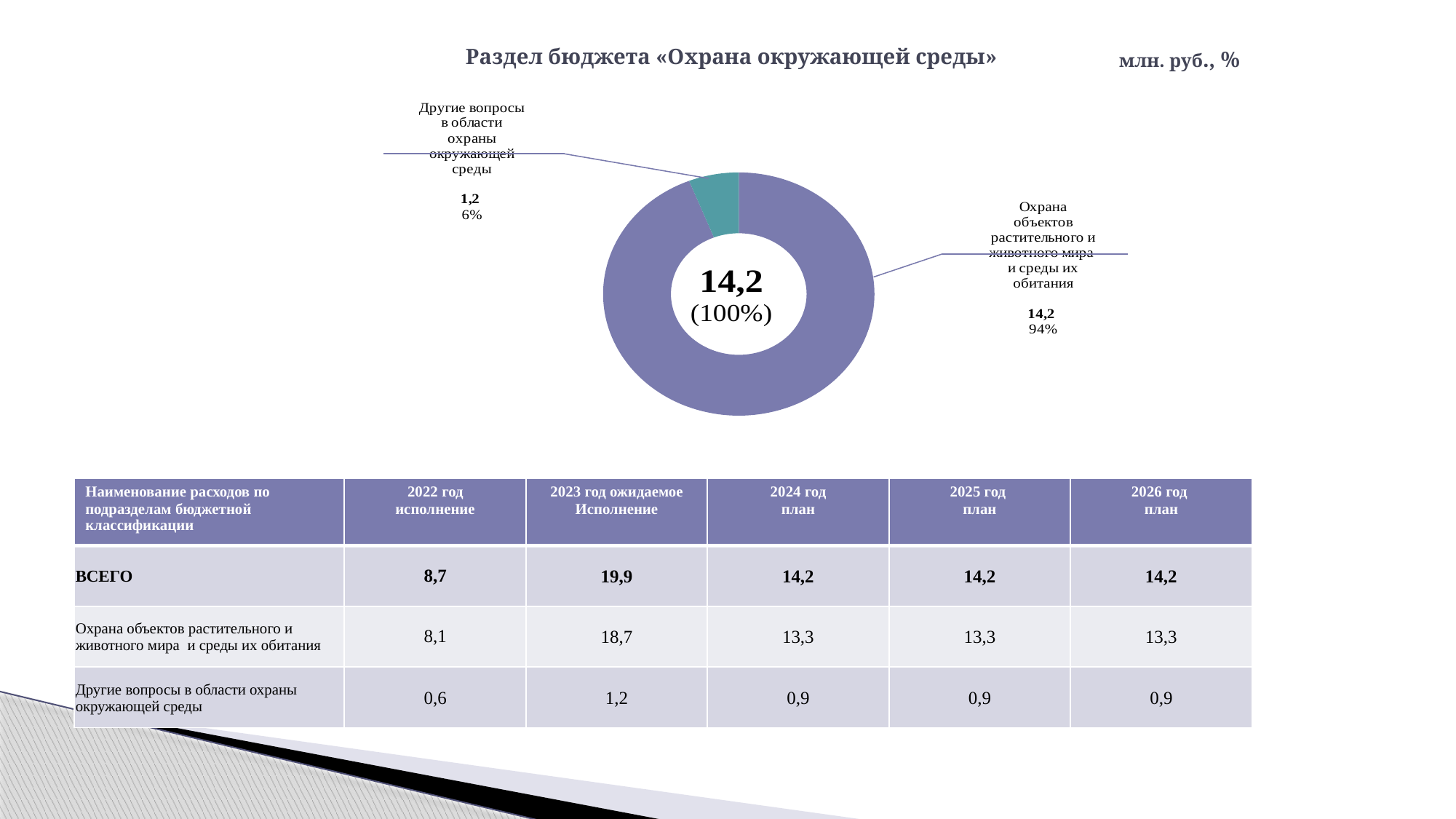
What percentage share is shown for «Другие вопросы в области охраны окружающей среды» in the donut chart? 6% Which is larger in the donut chart: the share for «Охрана объектов растительного и животного мира и среды их обитания» or the share for «Другие вопросы в области охраны окружающей среды»? Охрана объектов растительного и животного мира и среды их обитания Which slice of the donut chart is the largest? Охрана объектов растительного и животного мира и среды их обитания How many slices does the donut chart have? 2 Which slice of the donut chart is the smallest? Другие вопросы в области охраны окружающей среды What value is printed for the slice «Охрана объектов растительного и животного мира и среды их обитания» in the donut chart? 14,2 What units are indicated for the chart on the slide? млн. руб., % What kind of chart is shown on the slide? Donut (pie) chart What is the title of the chart on the slide? Раздел бюджета «Охрана окружающей среды» What percentage share is shown for «Охрана объектов растительного и животного мира и среды их обитания» in the donut chart? 94% What total value is shown in the centre of the donut chart? 14,2 (100%) What value is printed for the slice «Другие вопросы в области охраны окружающей среды» in the donut chart? 1,2